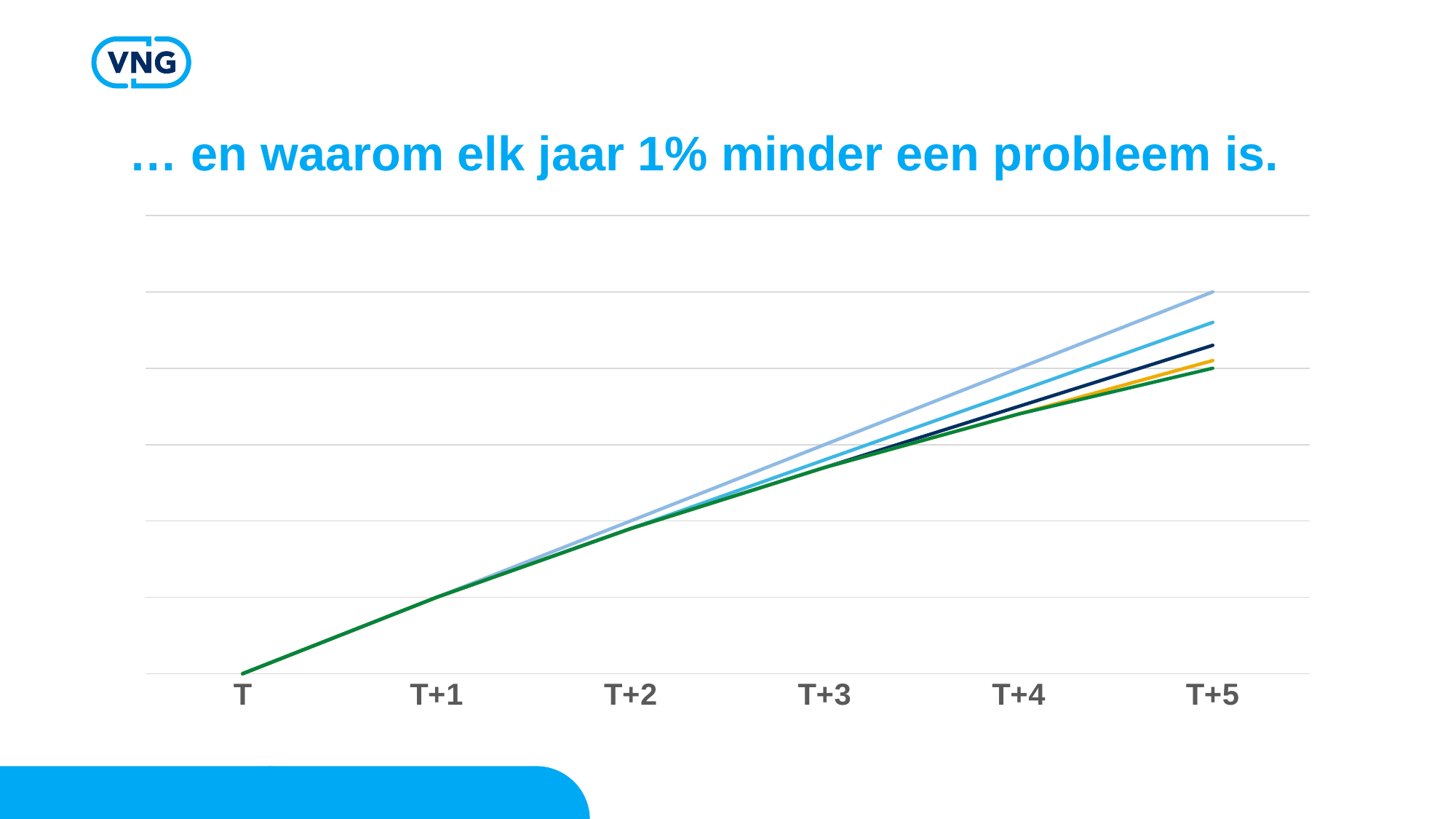
What is the label of the last point on the x axis? T+5 How many lines are plotted in the chart? 5 What is the label of the first point on the x axis? T At which x-axis point do all the lines start from the same value? T How many points are labelled along the x axis of the chart? 6 Do the lines in the chart rise or fall from T to T+5? rise What kind of chart is shown on the slide? line chart At T+5, is the light blue line higher or lower than the green line? higher Which coloured line is lowest at T+5? the green line Which coloured line is highest at T+5? the light blue line Does the gap between the lines widen or narrow as the x axis moves from T to T+5? widen